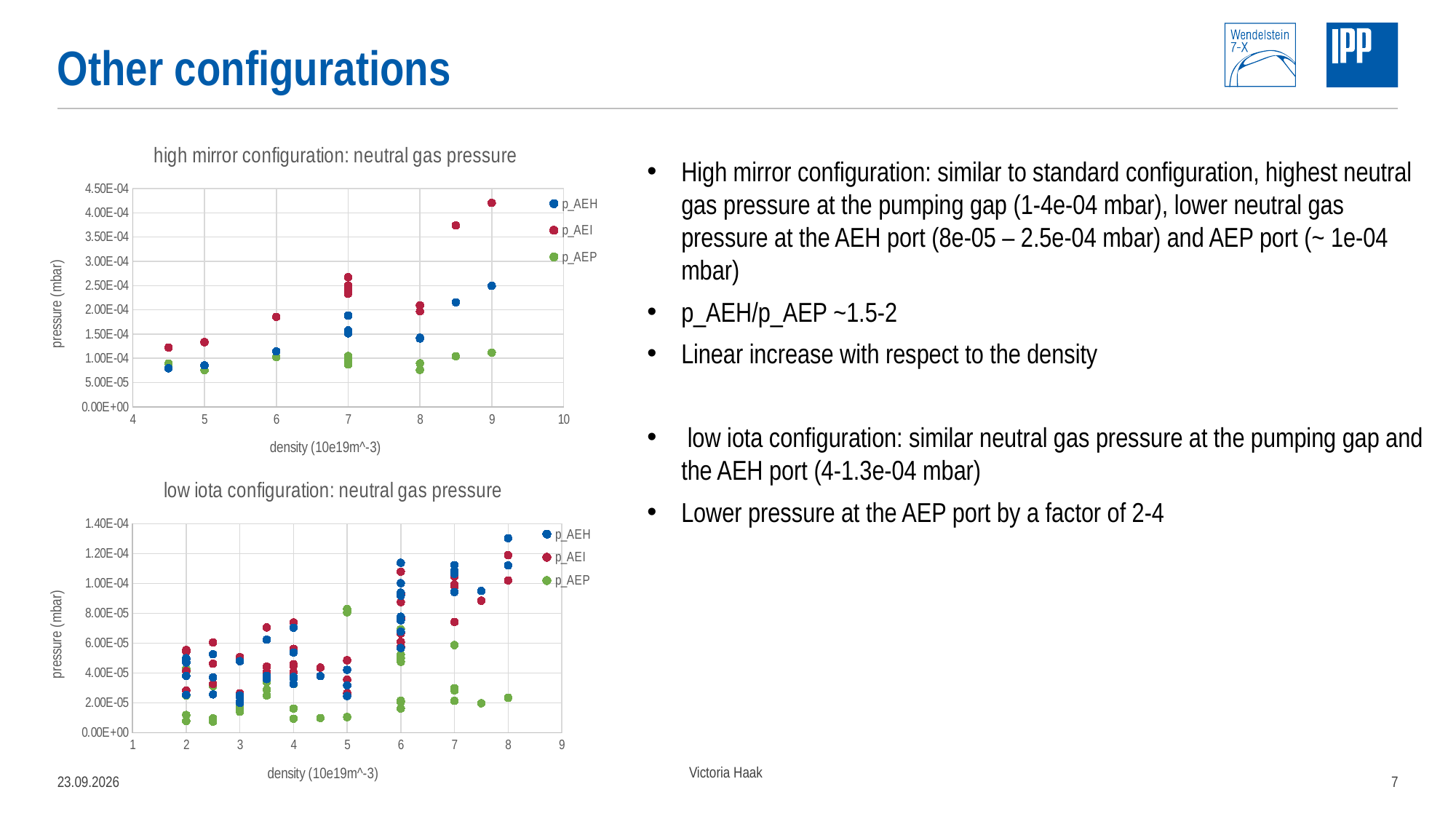
In the 'high mirror configuration: neutral gas pressure' chart, is the p_AEP value at density 9 greater or less than 1.50E-04? less In the 'high mirror configuration: neutral gas pressure' chart, does the p_AEI pressure rise or fall as density increases? rise What is the x-axis title of the 'low iota configuration: neutral gas pressure' chart? density (10e19m^-3) In the 'low iota configuration: neutral gas pressure' chart, is the highest p_AEH value at density 8 greater or less than 1.20E-04? greater In the 'high mirror configuration: neutral gas pressure' chart, is the p_AEI value at density 9 greater or less than 4.00E-04? greater In the 'low iota configuration: neutral gas pressure' chart, does the p_AEH pressure generally rise or fall as density increases? rise In the 'high mirror configuration: neutral gas pressure' chart, which series is plotted in green? p_AEP In the 'high mirror configuration: neutral gas pressure' chart, at density 9, which series has the larger value, p_AEI or p_AEP? p_AEI How many series does the legend of the 'low iota configuration: neutral gas pressure' chart list? 3 What kind of chart is the 'high mirror configuration: neutral gas pressure' chart? scatter chart In the 'low iota configuration: neutral gas pressure' chart, at density 8, which series has the larger values, p_AEH or p_AEP? p_AEH